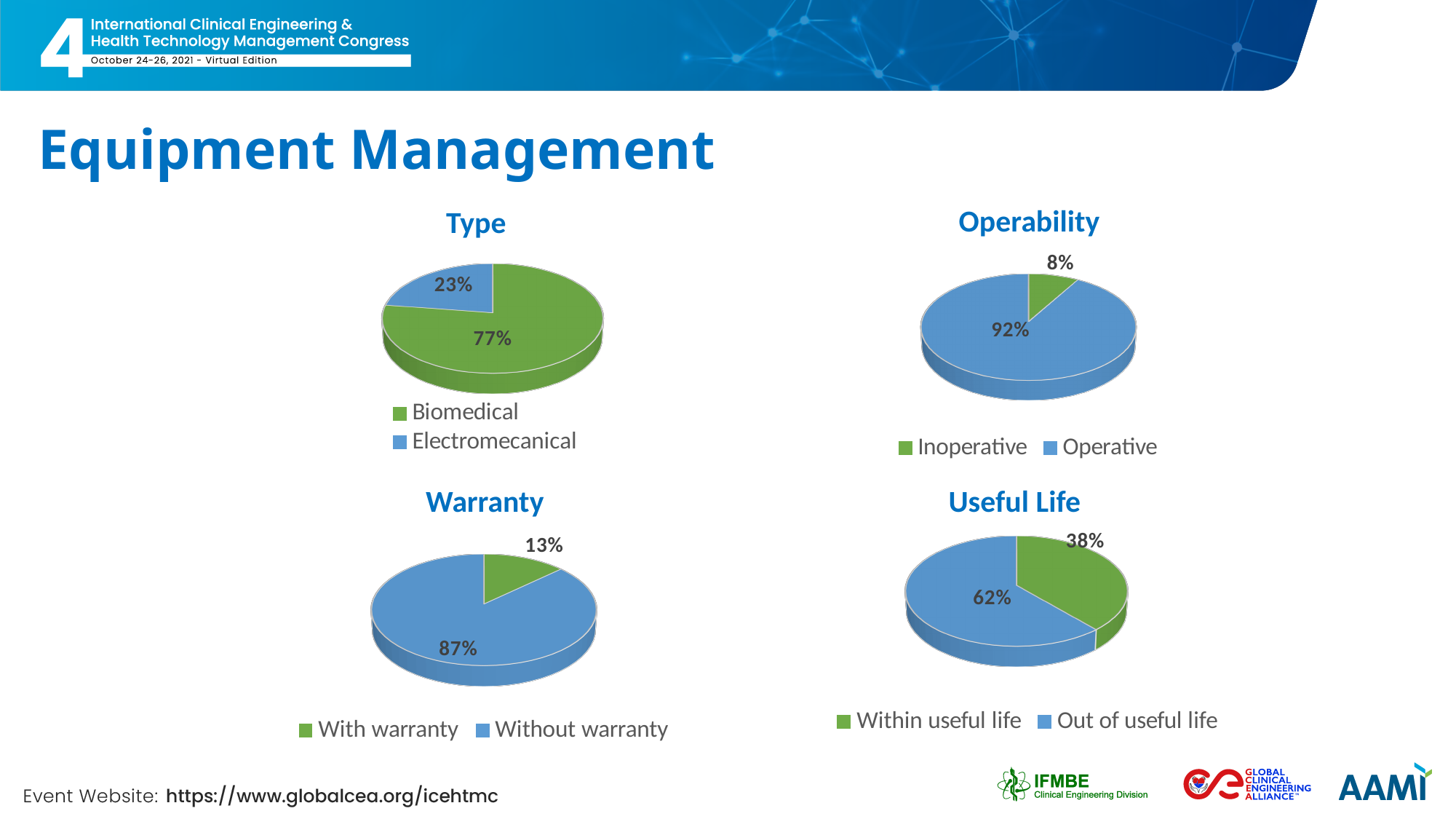
How many categories does the Useful Life chart's legend list? 2 What kind of chart is the Operability chart? Pie chart In the Useful Life chart, what is the difference between Out of useful life and Within useful life? 24% In the Useful Life chart, what share of the pie is Within useful life? 38% In the Operability chart, what percentage is Operative? 92% In the Warranty chart, which category is the smallest? With warranty In the Warranty chart, what percentage is With warranty? 13% In the Type chart, what percentage is Electromecanical? 23% In the Operability chart, what share of the pie is Inoperative? 8% In the Type chart, which category is the largest? Biomedical In the Warranty chart, what percentage is Without warranty? 87% In the Type chart, what percentage is Biomedical? 77%